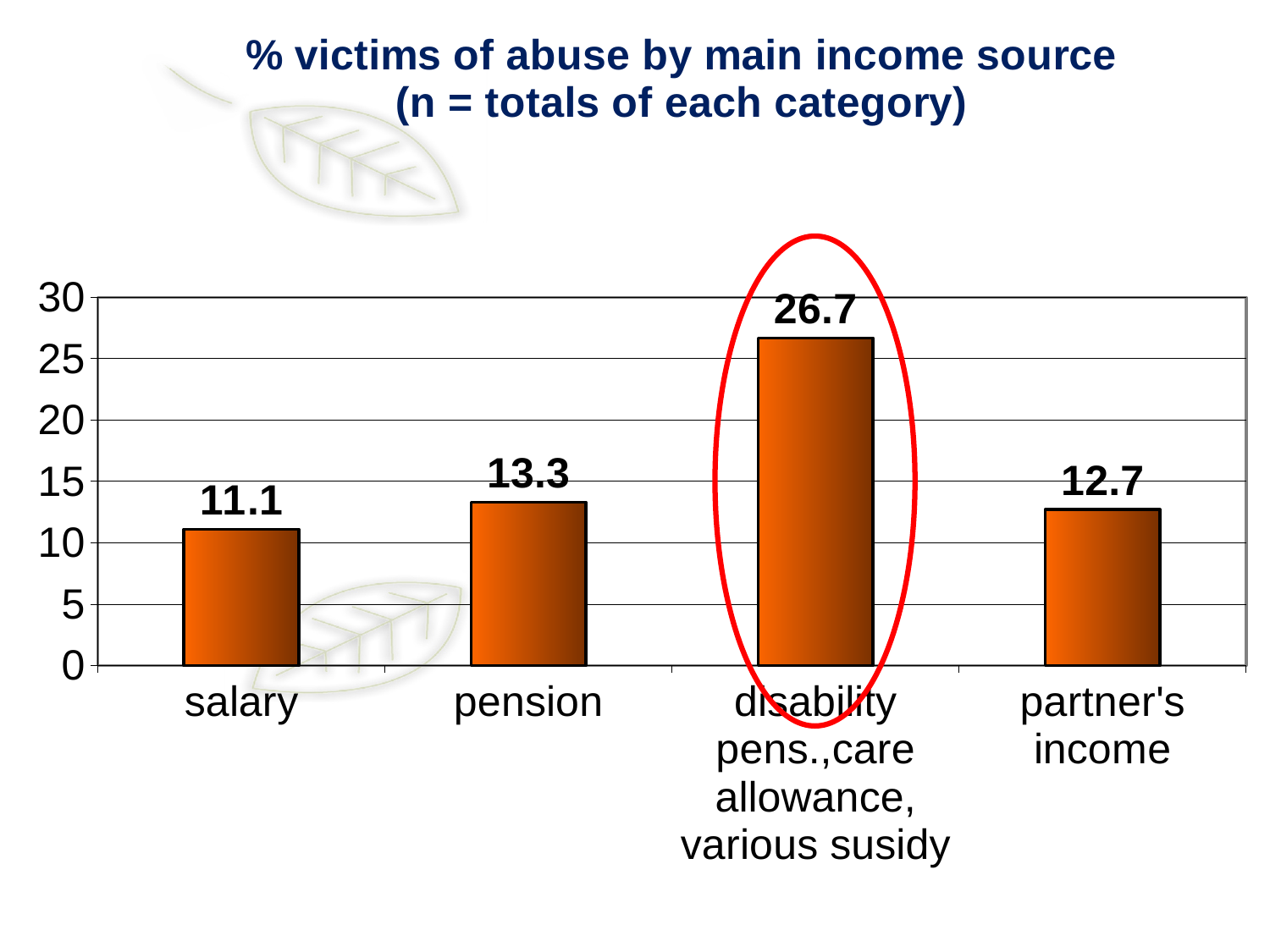
Which category has the lowest value? salary Which bar is circled in red on the chart? disability pens., care allowance, various susidy What is the difference between the values for pension and salary? 2.2 What is the value for salary? 11.1 What is the value for pension? 13.3 What is the value for the disability pens., care allowance, various susidy category? 26.7 Which is larger, the value for pension or the value for partner's income? pension What is the difference between the disability pens., care allowance, various susidy value and the partner's income value? 14.0 Which category has the highest value? disability pens., care allowance, various susidy What kind of chart is shown on the slide? bar chart What is the value for partner's income? 12.7 How many categories are shown on the x axis? 4